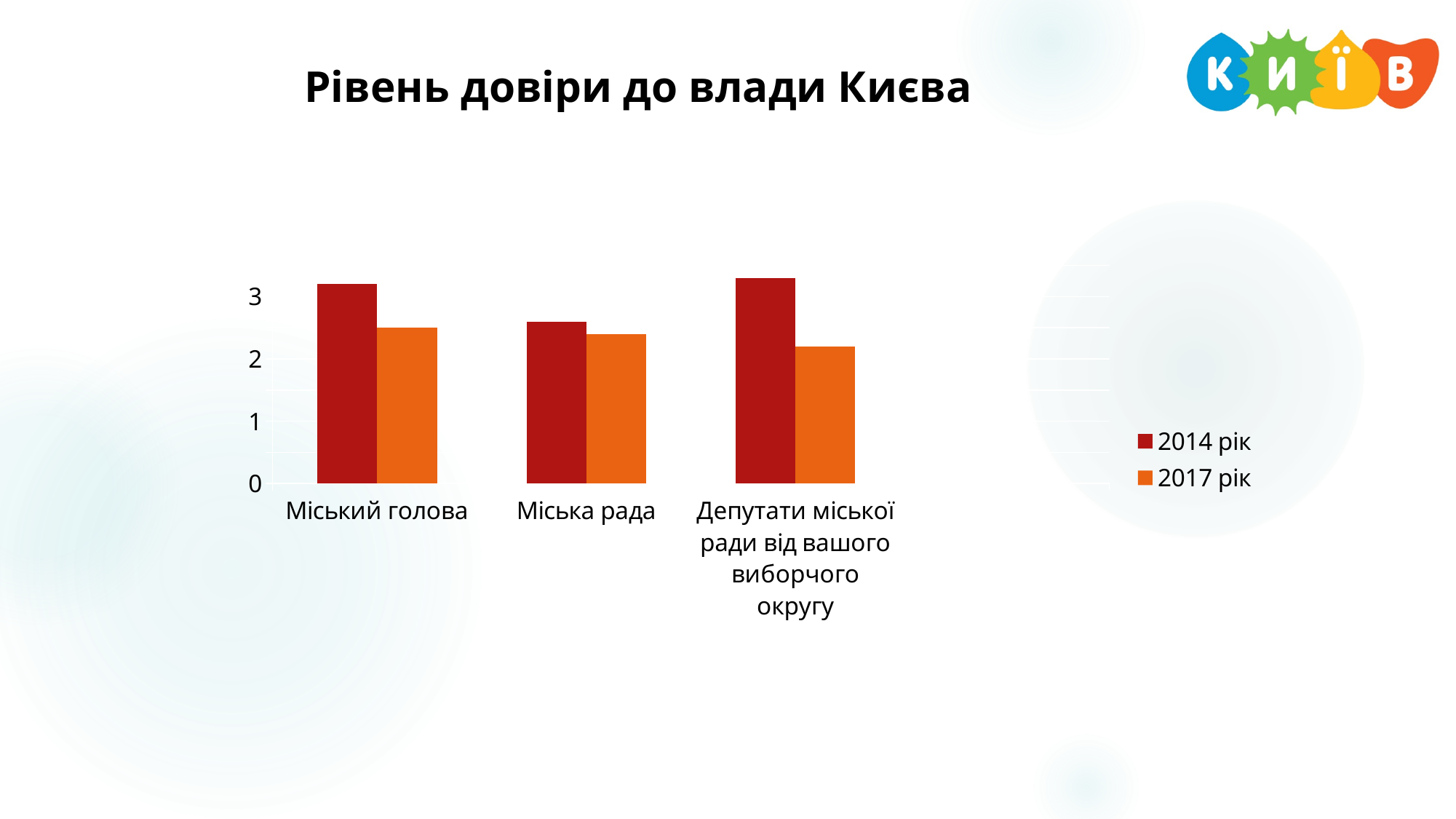
Is the value for Міська рада in 2014 рік greater or less than 3? less Is the value for Депутати міської ради від вашого виборчого округу in 2017 рік greater or less than 3? less What kind of chart is shown on the slide? bar chart Which series is shown in orange in the legend? 2017 рік Is the value for Міський голова in 2017 рік greater or less than 2? greater What is the title of the chart? Рівень довіри до влади Києва Which category has the lowest value in the 2014 рік series? Міська рада How many categories are shown on the x axis? 3 For Міський голова, which is larger: the 2014 рік value or the 2017 рік value? 2014 рік How many series does the legend list? 2